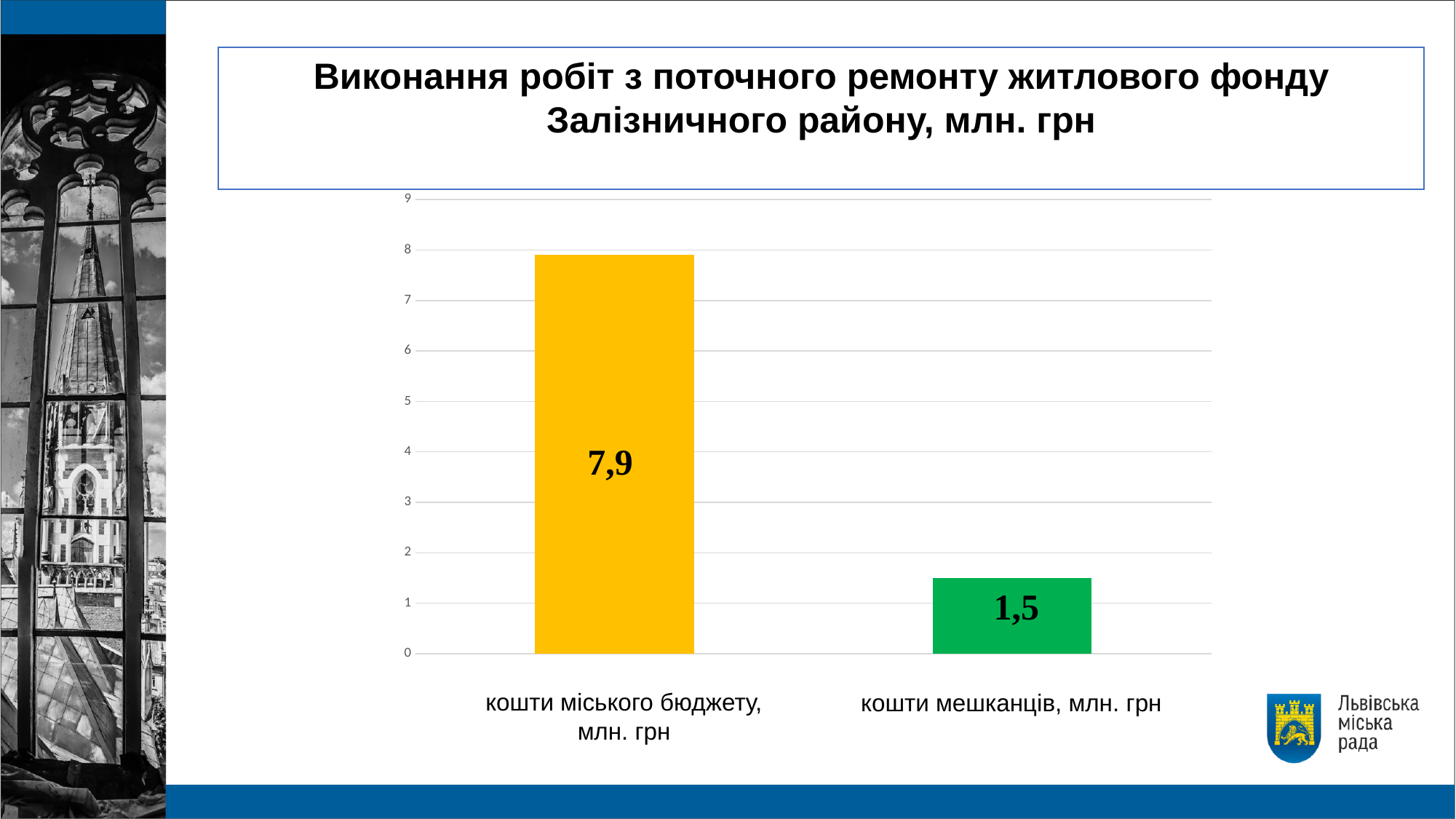
What is the title of the chart? Виконання робіт з поточного ремонту житлового фонду Залізничного району, млн. грн How many categories are shown in the chart? 2 What colour is the bar for кошти мешканців? green Is the value for кошти мешканців greater or less than 2? less Is the value for кошти міського бюджету greater or less than 7? greater Which category has the lowest value? кошти мешканців, млн. грн What is the difference between the value for кошти міського бюджету and the value for кошти мешканців? 6,4 What is the value for кошти мешканців, млн. грн? 1,5 Which category has the highest value? кошти міського бюджету, млн. грн What kind of chart is shown on the slide? bar chart Which is larger: the value for кошти міського бюджету or the value for кошти мешканців? кошти міського бюджету What is the value for кошти міського бюджету, млн. грн? 7,9